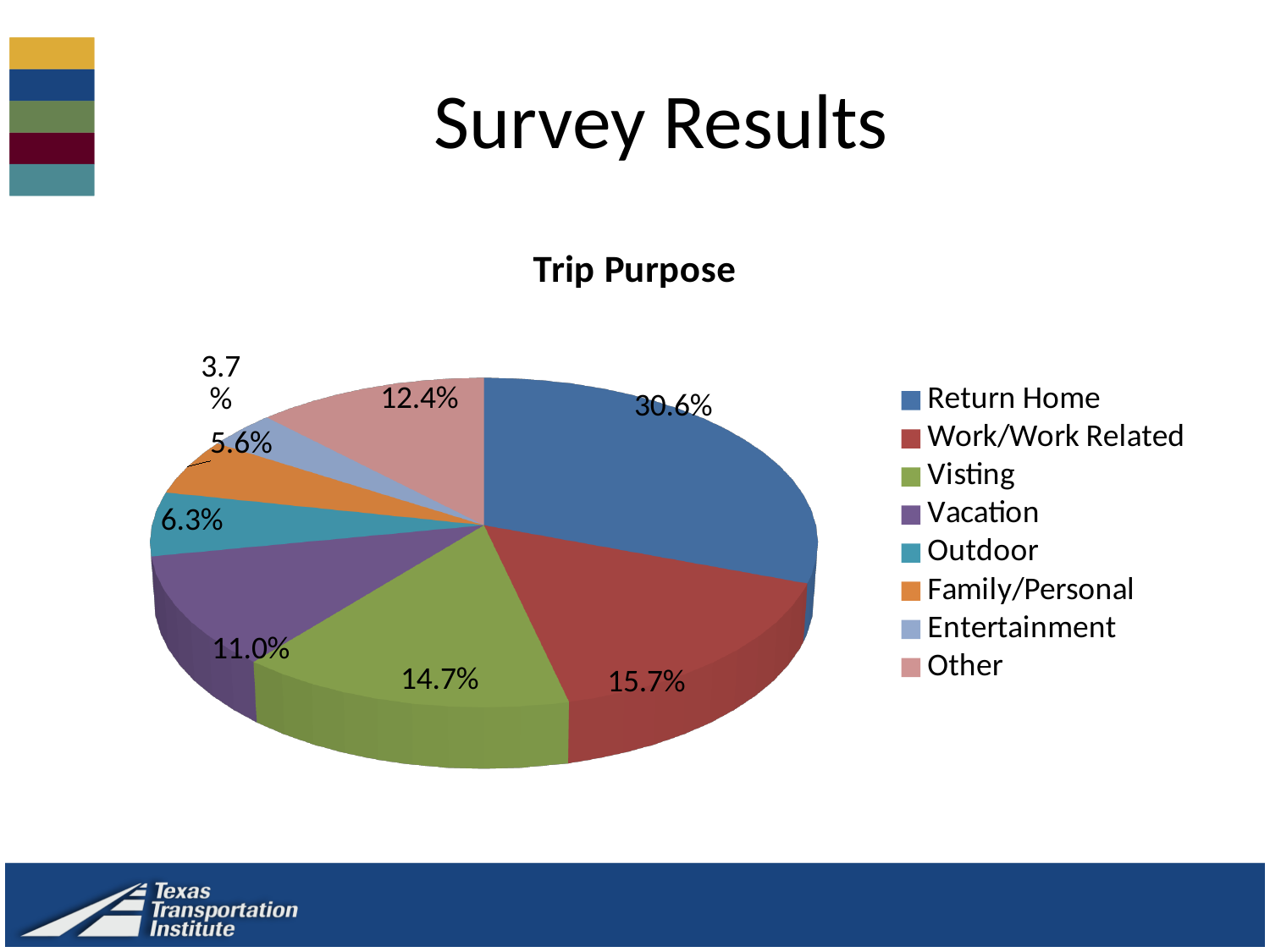
What kind of chart is shown on the slide? Pie chart What percentage of trips are Work/Work Related? 15.7% Which is larger, the share for Outdoor or the share for Family/Personal? Outdoor Which trip purpose has the largest share of the pie? Return Home What is the difference between the Return Home share and the Work/Work Related share? 14.9% What is the share of the pie for the Other category? 12.4% What is the title of the chart? Trip Purpose Which trip purpose has the smallest share of the pie? Entertainment How many trip purpose categories are shown in the pie chart? 8 What percentage of trips are for Vacation? 11.0% What percentage of trips are for Return Home? 30.6% What percentage of trips are for Entertainment? 3.7%